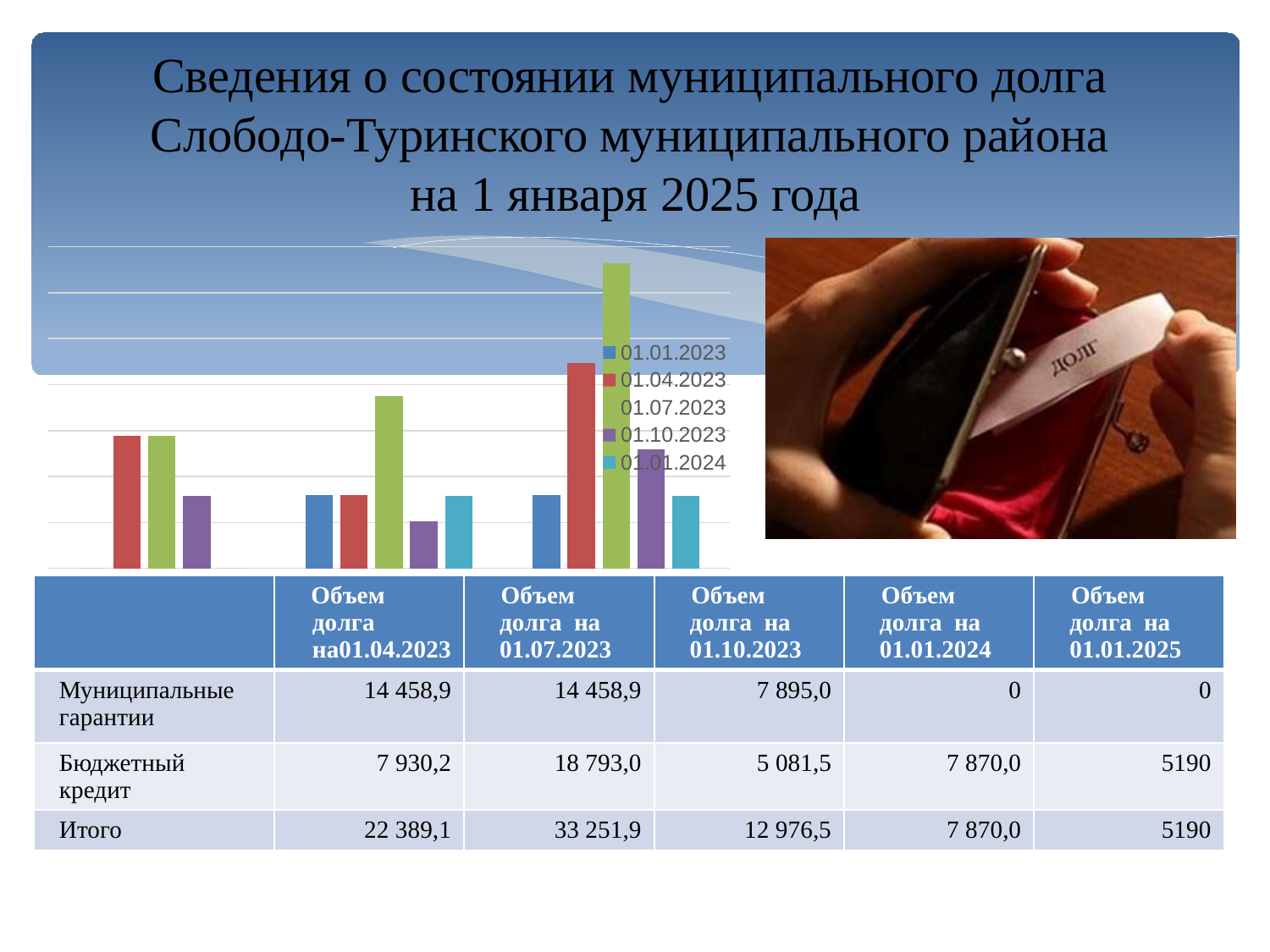
What kind of chart is shown on the slide? bar chart Which series is listed first in the chart legend? 01.01.2023 How many groups of bars does the chart show? 3 How many series does the chart legend list? 5 In the middle group of bars, which series has the shortest bar? 01.10.2023 In the rightmost group of bars, which is taller: the 01.04.2023 bar or the 01.10.2023 bar? 01.04.2023 In the middle group of bars, which series has the tallest bar? 01.07.2023 Which series is shown in green in the chart legend? 01.07.2023 In the rightmost group of bars, which series has the tallest bar? 01.07.2023 In the middle group of bars, which is taller: the 01.07.2023 bar or the 01.01.2024 bar? 01.07.2023